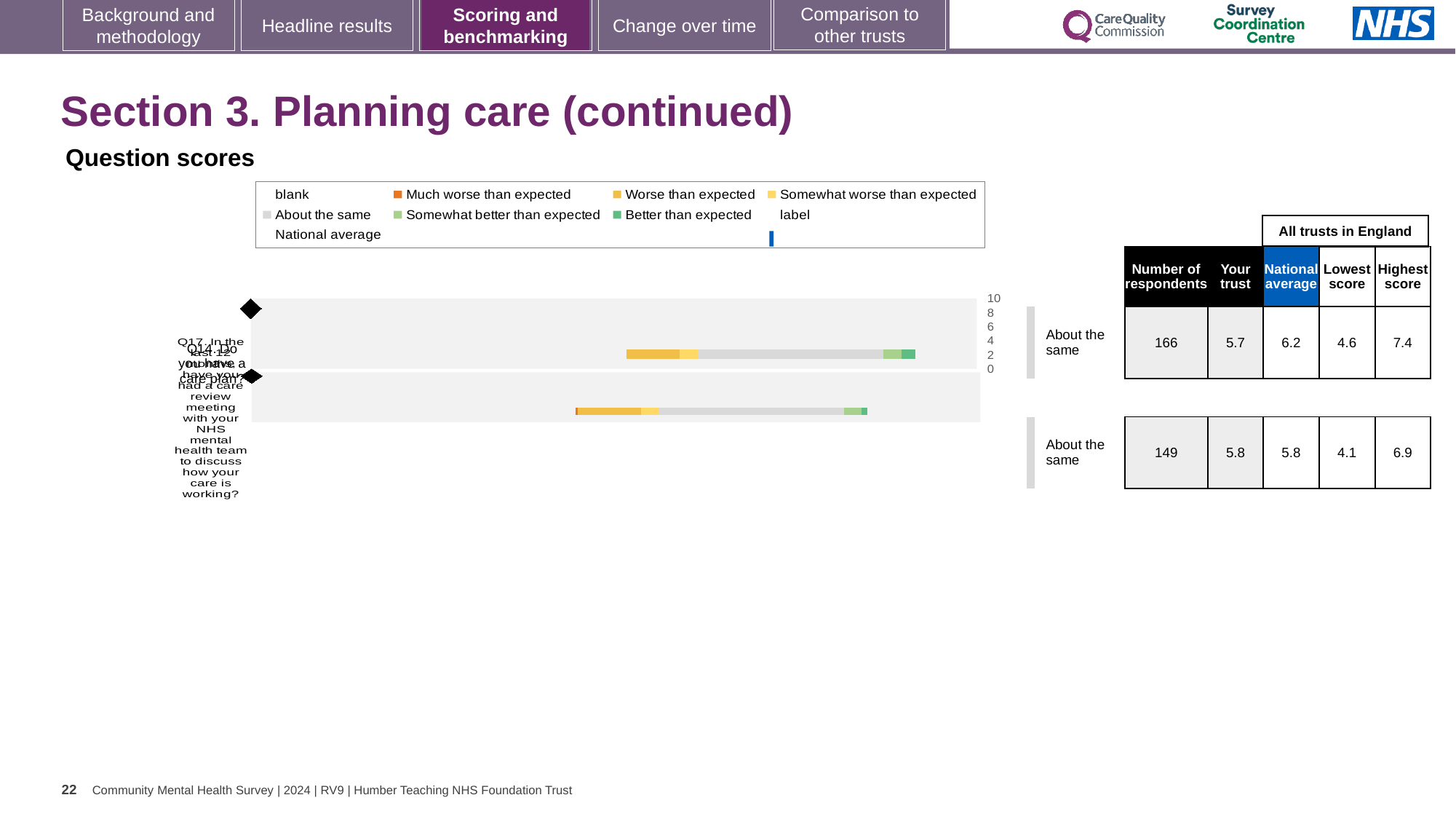
In the table next to the chart, how many respondents are shown for the top row (Q14, care plan)? 166 What is the maximum value shown on the chart's score axis? 10 What kind of chart is shown on the slide? Bar chart What is the highest score across all trusts in England for the top row (Q14)? 7.4 What is the lowest score across all trusts in England for the top row (Q14)? 4.6 What benchmark category is shown for both questions on the slide? About the same Which row has more respondents, the top row (Q14) or the bottom row (Q17)? Top row (Q14), 166 What is the 'Your trust' score for the bottom row (Q17) in the table? 5.8 How many respondents are shown for the bottom row (Q17, care review meeting)? 149 What is the difference between the highest score and the lowest score for the top row (Q14)? 2.8 What is the national average for the top row (Q14) in the table? 6.2 What is the 'Your trust' score for the top row (Q14) in the table? 5.7